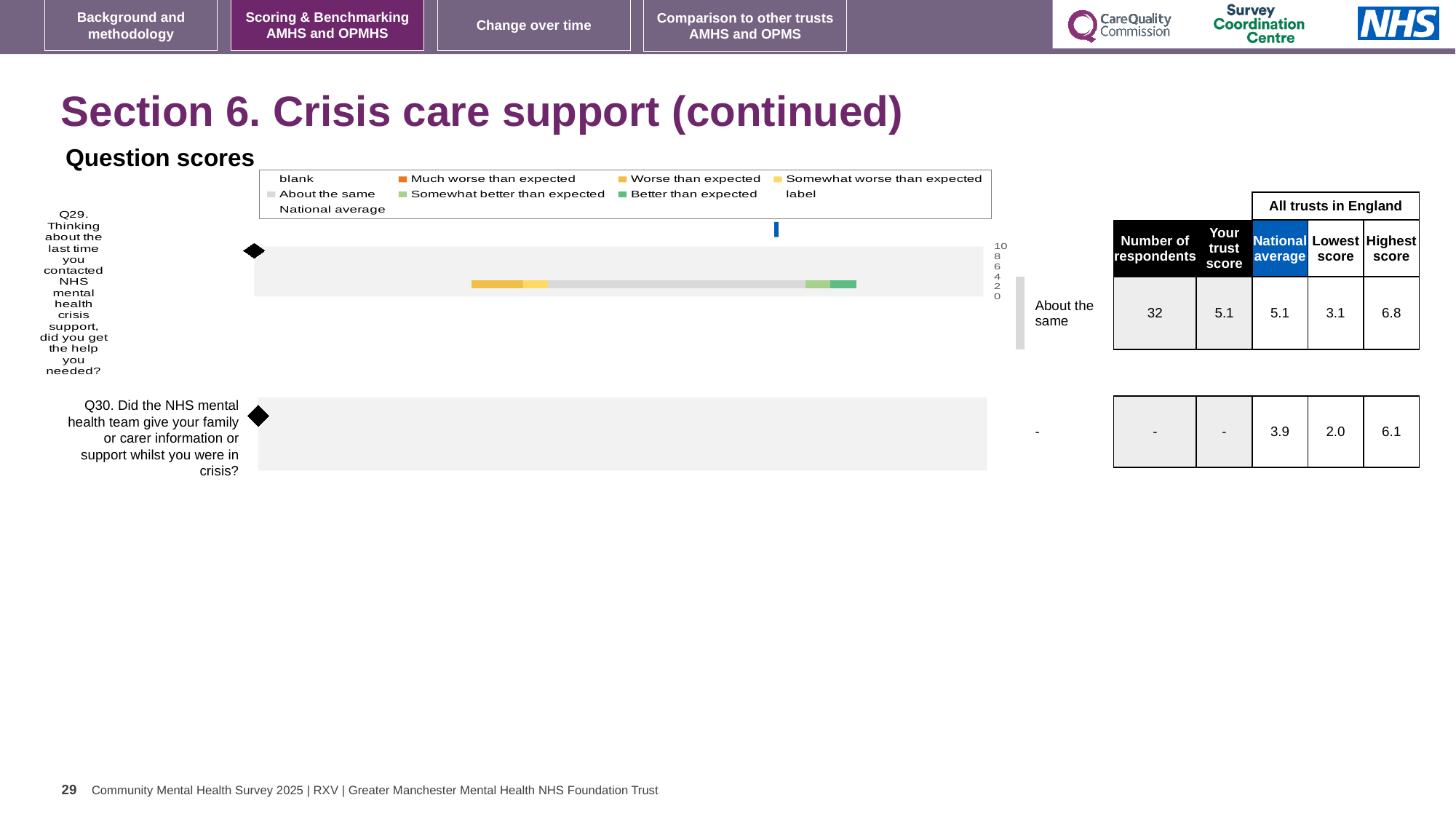
In the question scores chart legend, which colour represents 'Better than expected'? green Which question has the higher highest score across all trusts in England, Q29 or Q30? Q29 How many questions are plotted in the question scores chart? 2 What kind of chart is used to show the question scores on this slide? bar chart How many respondents are shown for Q29? 32 What benchmark category is shown for Q29 in the question scores chart? About the same What is the difference between the highest score and the lowest score for Q30? 4.1 What is the difference between the highest score and the lowest score for Q29? 3.7 What is the national average for Q29? 5.1 What is the national average for Q30? 3.9 What is the trust score for Q29? 5.1 What is the highest score across all trusts in England for Q29? 6.8